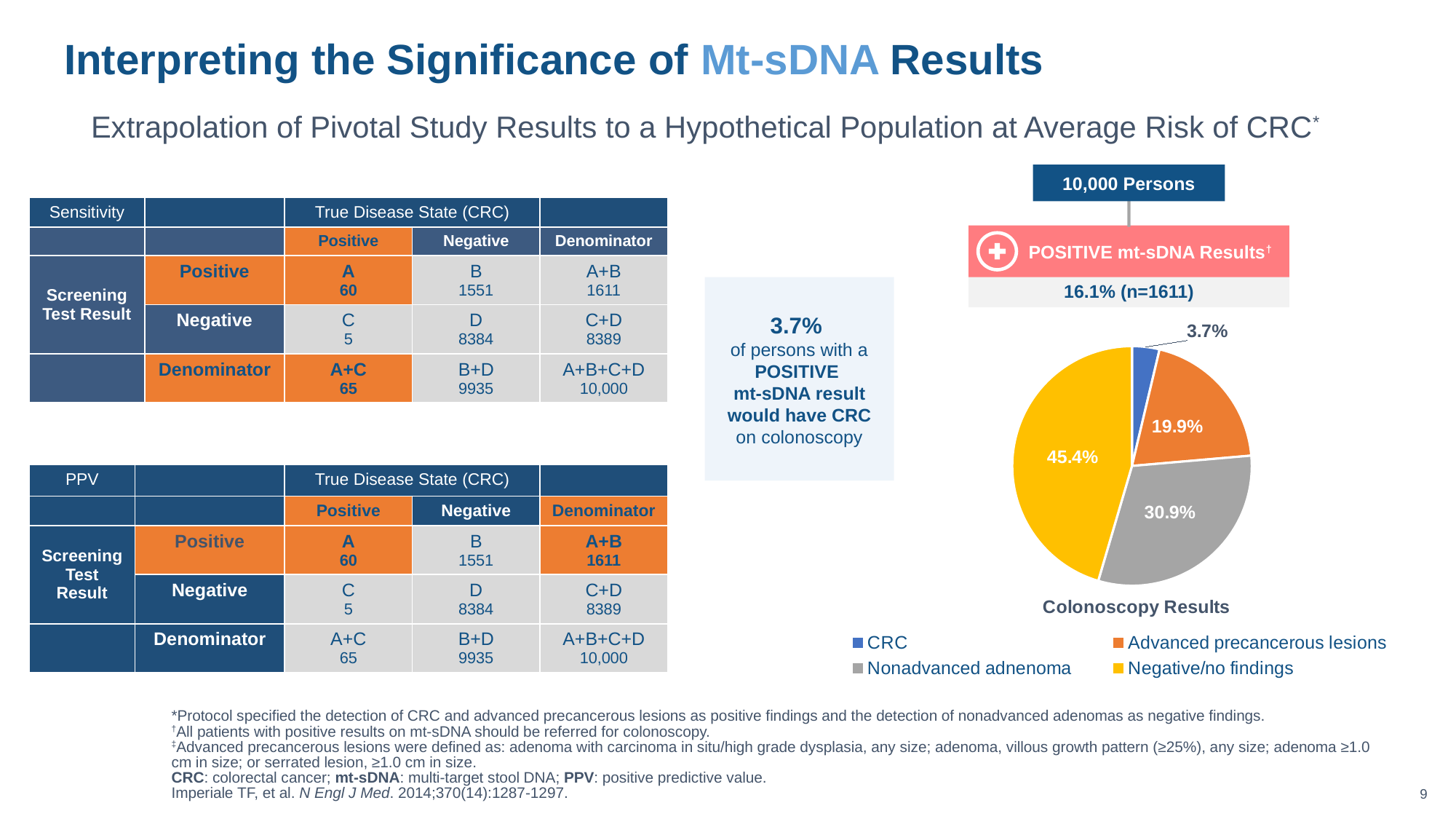
In the Colonoscopy Results pie chart, which is larger: the Advanced precancerous lesions slice or the Nonadvanced adnenoma slice? Nonadvanced adnenoma In the Colonoscopy Results pie chart, what share is labelled for Negative/no findings? 45.4% In the Colonoscopy Results pie chart, which category has the smallest slice? CRC In the Colonoscopy Results pie chart, what share is labelled for Advanced precancerous lesions? 19.9% In the Colonoscopy Results pie chart, what share is labelled for CRC? 3.7% In the Colonoscopy Results pie chart, which category has the largest slice? Negative/no findings In the Colonoscopy Results pie chart, what share is labelled for Nonadvanced adnenoma? 30.9% In the Colonoscopy Results pie chart, what colour is the Negative/no findings slice? Yellow What type of chart is shown under the heading "Colonoscopy Results"? Pie chart In the Colonoscopy Results pie chart, what is the difference between the Negative/no findings share and the Nonadvanced adnenoma share? 14.5% How many slices does the Colonoscopy Results pie chart have? 4 How many entries does the legend of the Colonoscopy Results pie chart list? 4